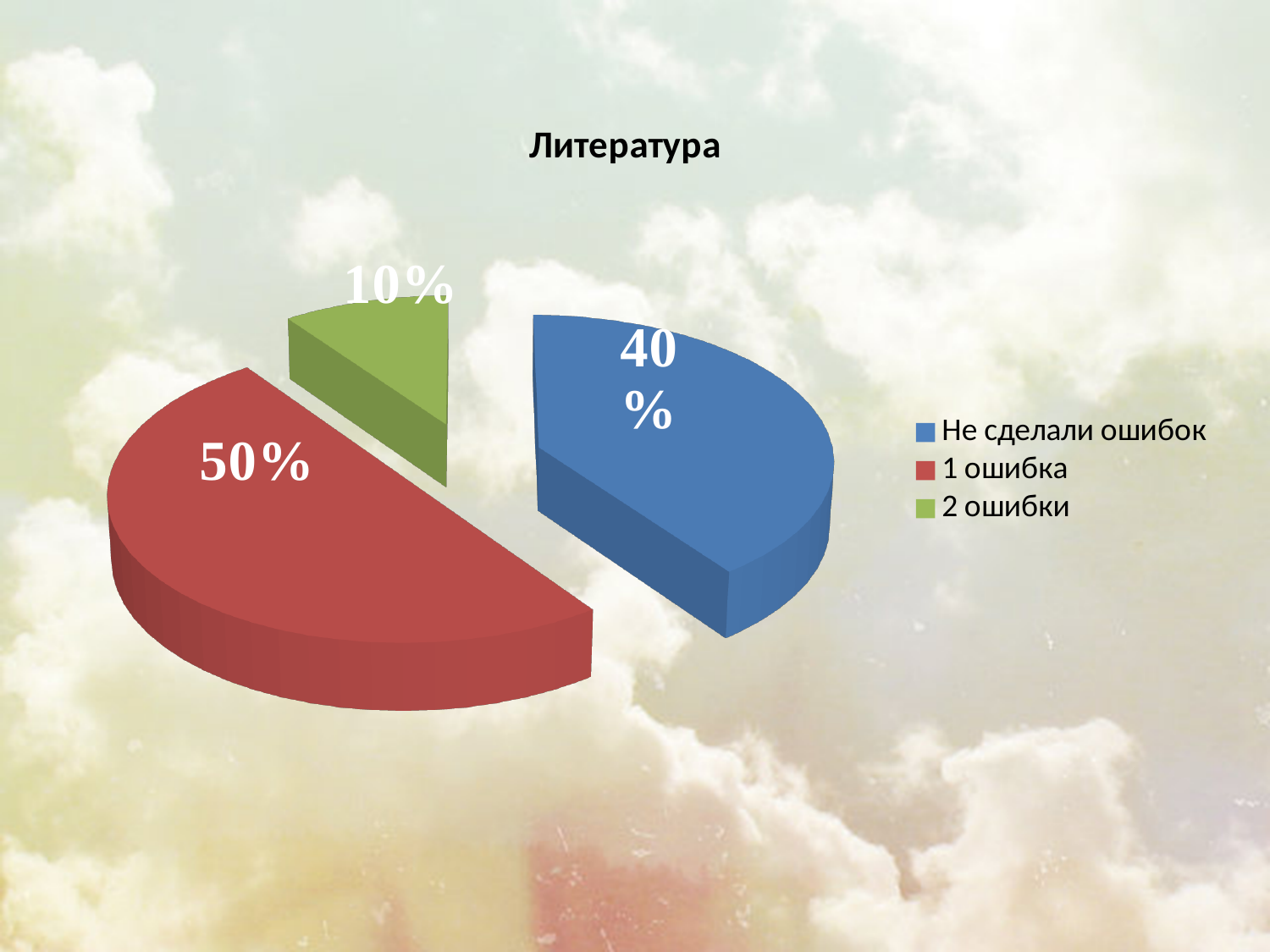
What share of the pie is labelled "2 ошибки"? 10% How many slices does the pie chart have? 3 What is the difference between the shares for "1 ошибка" and "Не сделали ошибок"? 10% Which category has the smallest slice of the pie? 2 ошибки What share of the pie is labelled "Не сделали ошибок"? 40% What colour is the slice for "2 ошибки"? green Which category has the largest slice of the pie? 1 ошибка Which is larger, the share for "Не сделали ошибок" or the share for "2 ошибки"? Не сделали ошибок How many entries does the legend list? 3 What kind of chart is shown on the slide? pie chart What share of the pie is labelled "1 ошибка"? 50% What is the title of the chart? Литература